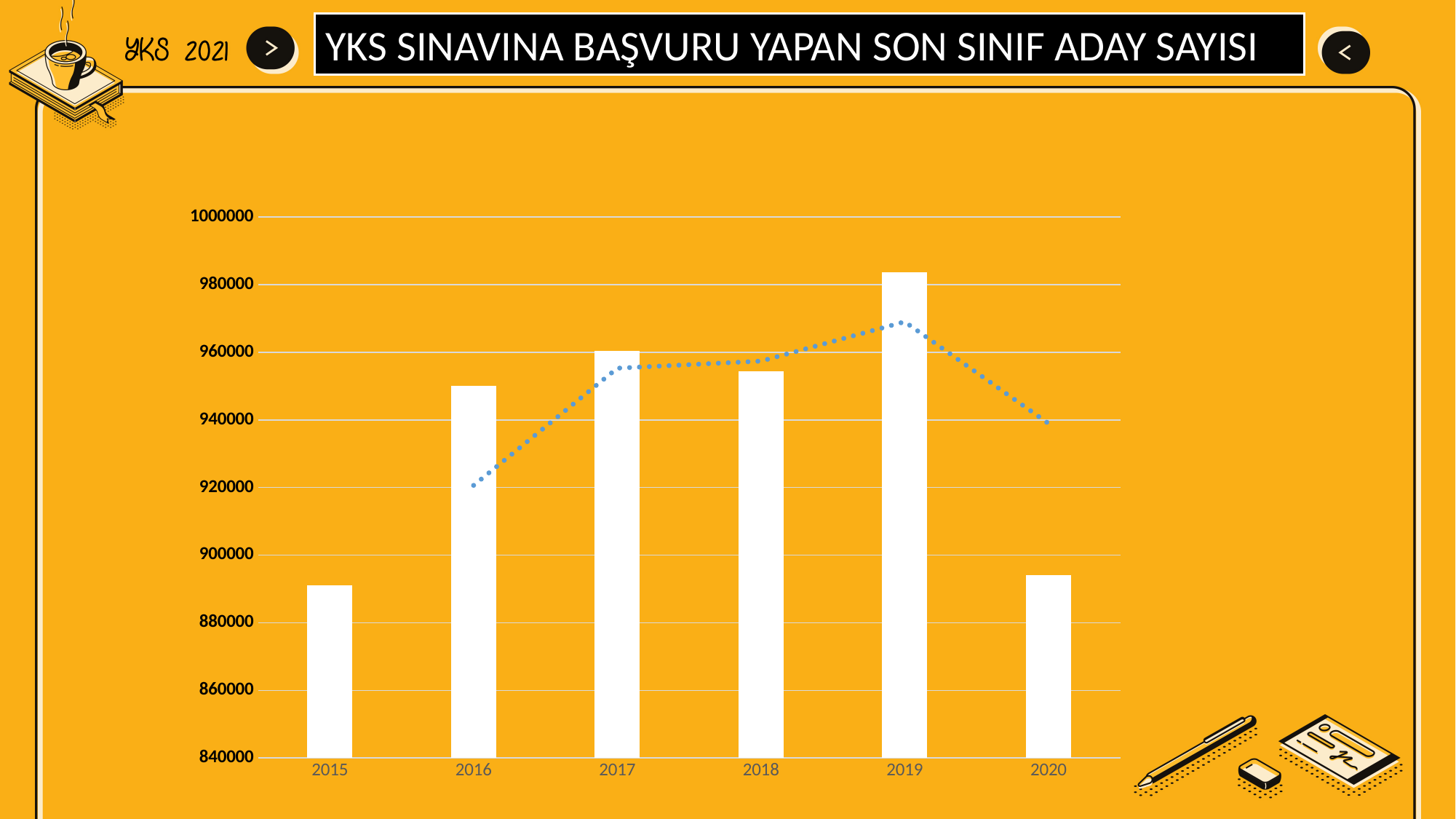
Is the value for 2016 greater or less than 940000? greater Is the value for 2018 greater or less than 960000? less Is the value for 2020 greater or less than 900000? less What is the title of the chart? YKS SINAVINA BAŞVURU YAPAN SON SINIF ADAY SAYISI Which is larger, the value for 2015 or the value for 2017? 2017 How many years are shown on the x axis of the chart? 6 Which year has the highest bar in the chart? 2019 Does the value rise or fall from 2019 to 2020? fall Which is larger, the value for 2016 or the value for 2019? 2019 What kind of chart is shown on the slide? bar chart